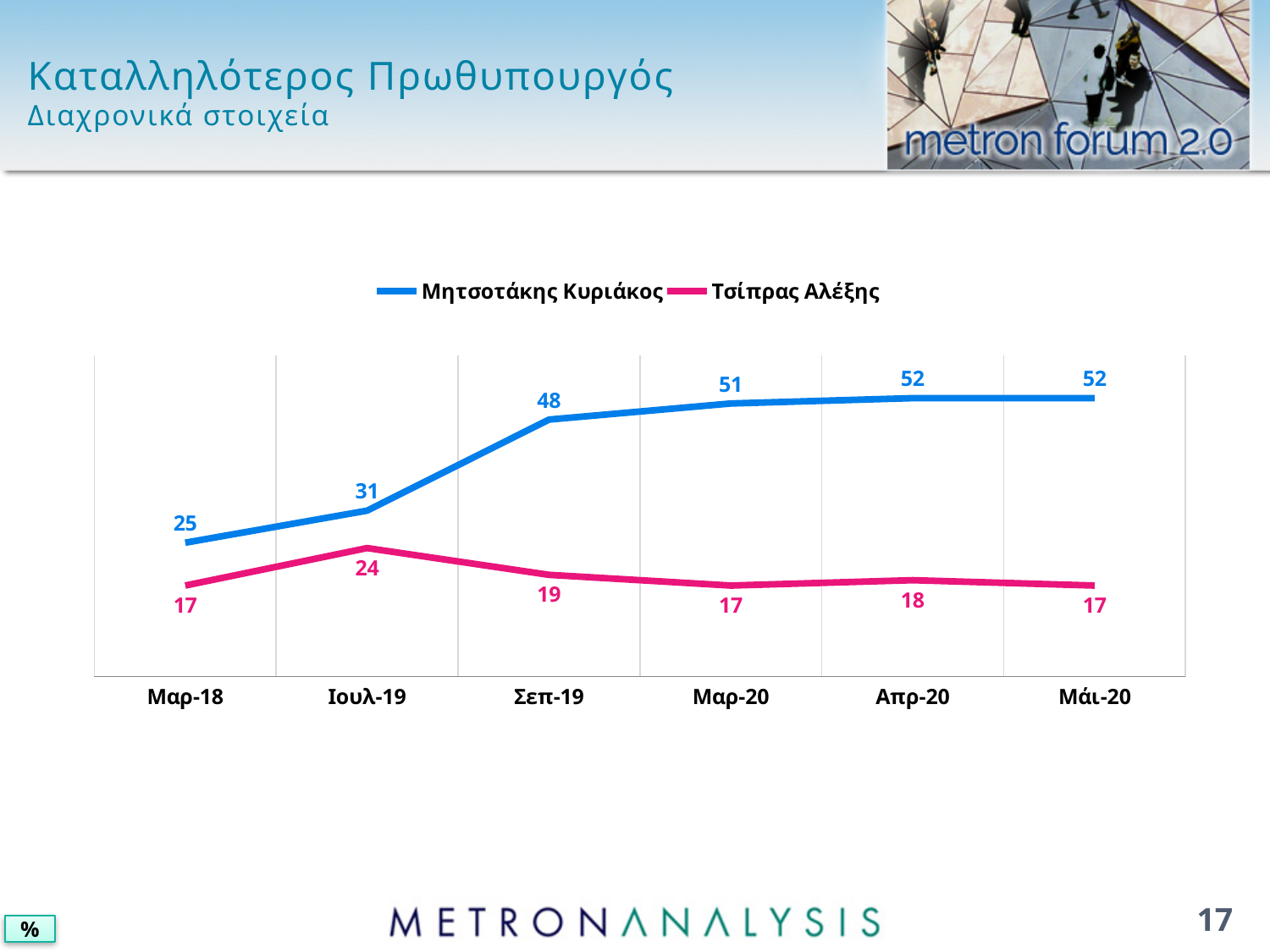
What is the value for Τσίπρας Αλέξης in Ιουλ-19? 24 What is the value for Μητσοτάκης Κυριάκος in Σεπ-19? 48 What kind of chart is shown on the slide? Line chart How many time periods are shown on the x axis? 6 Does the value for Μητσοτάκης Κυριάκος rise or fall from Μαρ-18 to Σεπ-19? Rise What is the difference between the values for Μητσοτάκης Κυριάκος and Τσίπρας Αλέξης in Μάι-20? 35 In which period does Τσίπρας Αλέξης reach his highest value? Ιουλ-19 In which period does Μητσοτάκης Κυριάκος have his lowest value? Μαρ-18 How many series does the legend list? 2 What is the difference between the Μητσοτάκης Κυριάκος values in Σεπ-19 and Ιουλ-19? 17 What is the value for Μητσοτάκης Κυριάκος in Μαρ-18? 25 Which series has the higher value in Μαρ-20, Μητσοτάκης Κυριάκος or Τσίπρας Αλέξης? Μητσοτάκης Κυριάκος